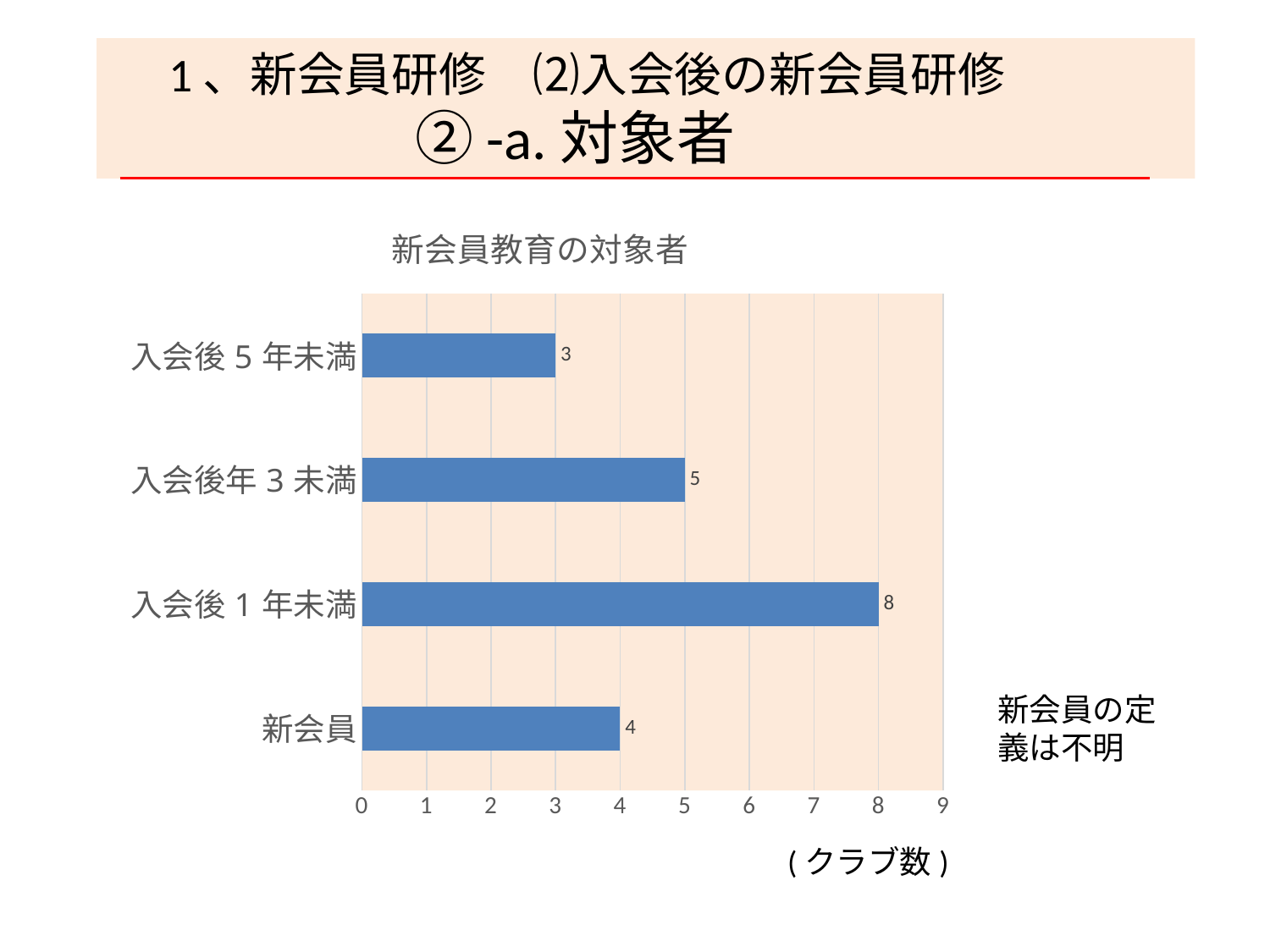
What is the difference between the values for 入会後１年未満 and 新会員? 4 Which category has the highest value? 入会後１年未満 What is the value for 入会後年３未満? 5 Is the value for 入会後１年未満 greater or less than 6? greater What is the value for 入会後５年未満? 3 What is the title of the chart? 新会員教育の対象者 Which category has the lowest value? 入会後５年未満 How many categories are shown in the chart? 4 What is the value for 入会後１年未満? 8 What kind of chart is shown on the slide? bar chart Which is larger, the value for 入会後年３未満 or the value for 新会員? 入会後年３未満 What is the value for 新会員? 4